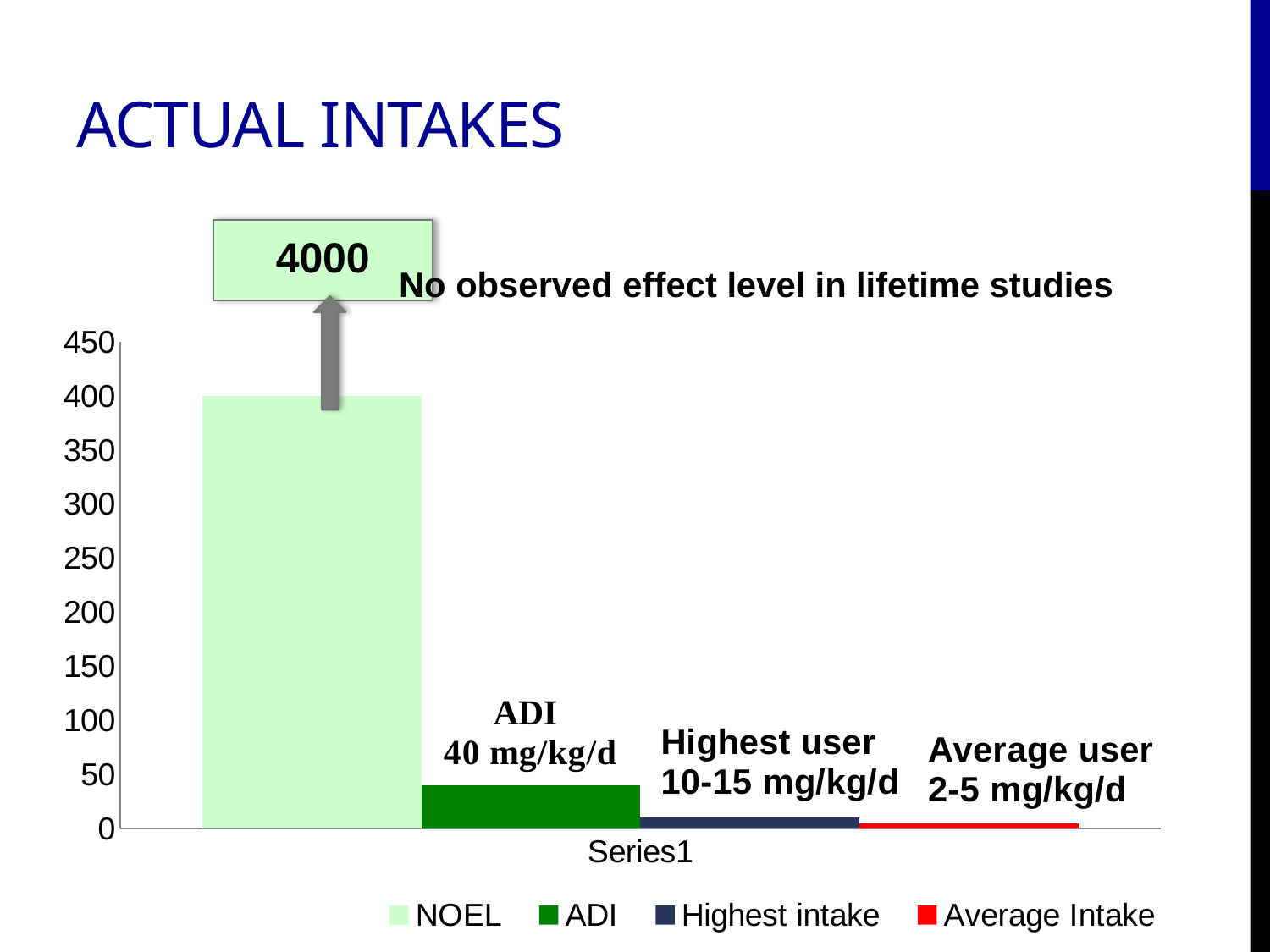
Is the NOEL bar greater or less than 350 on the axis? greater What intake range is labelled for the highest user? 10-15 mg/kg/d Which is larger, the ADI bar or the Highest intake bar? ADI Is the value for Highest intake greater or less than 50? less What colour is the Average Intake series in the legend? red What kind of chart is shown on the slide? bar chart Which series has the shortest bar? Average Intake What intake range is labelled for the average user? 2-5 mg/kg/d What is the title of the slide containing the chart? ACTUAL INTAKES What value is labelled for ADI on the chart? 40 mg/kg/d How many series does the legend list? 4 Which series has the tallest bar? NOEL